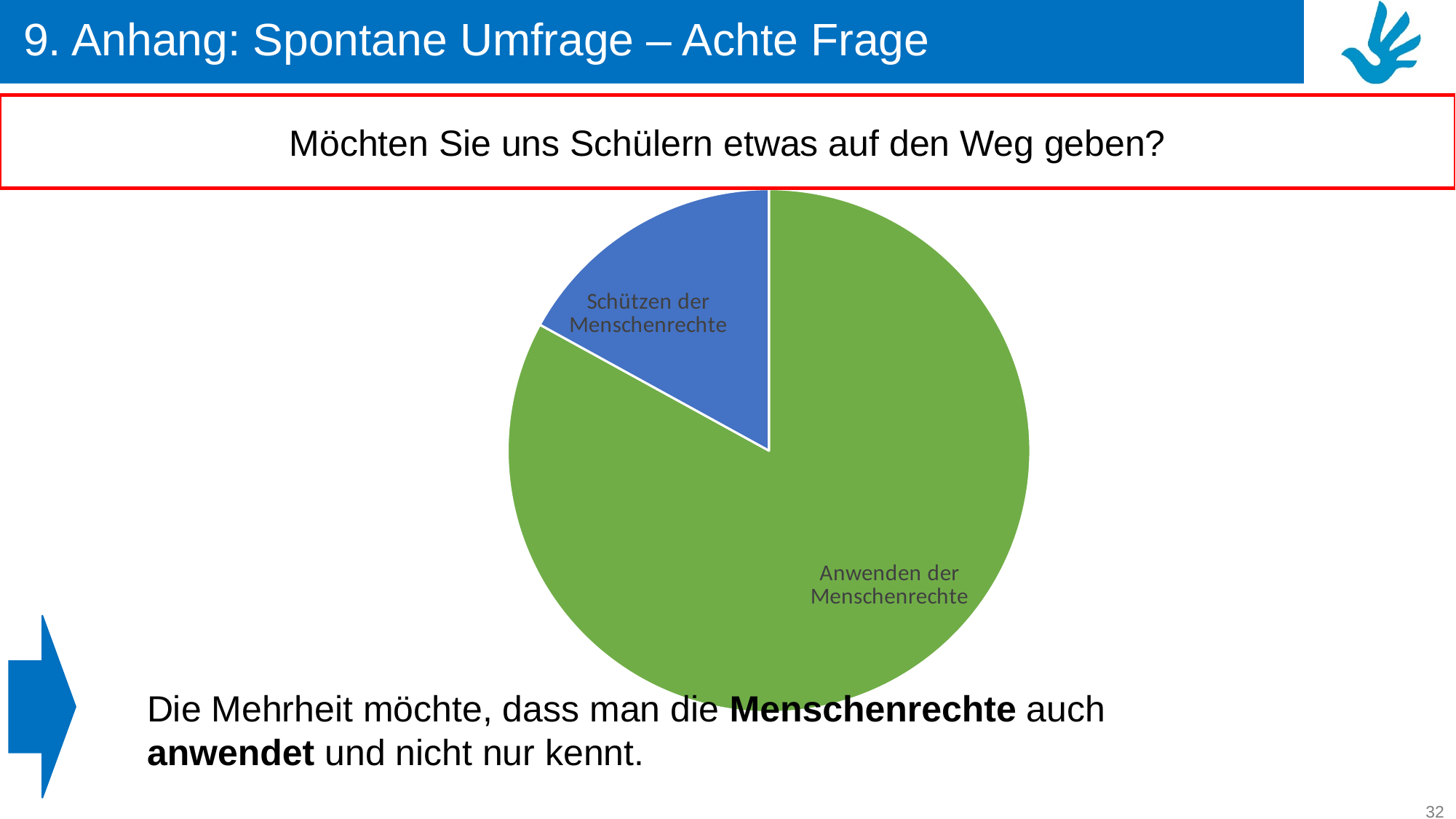
What are the labels of the two slices in the pie chart? Schützen der Menschenrechte; Anwenden der Menschenrechte Which slice is larger, "Schützen der Menschenrechte" or "Anwenden der Menschenrechte"? Anwenden der Menschenrechte What kind of chart is shown on the slide? pie chart What colour is the "Anwenden der Menschenrechte" slice? green Which slice of the pie chart is the largest? Anwenden der Menschenrechte What colour is the "Schützen der Menschenrechte" slice? blue How many slices does the pie chart have? 2 Which slice of the pie chart is the smallest? Schützen der Menschenrechte